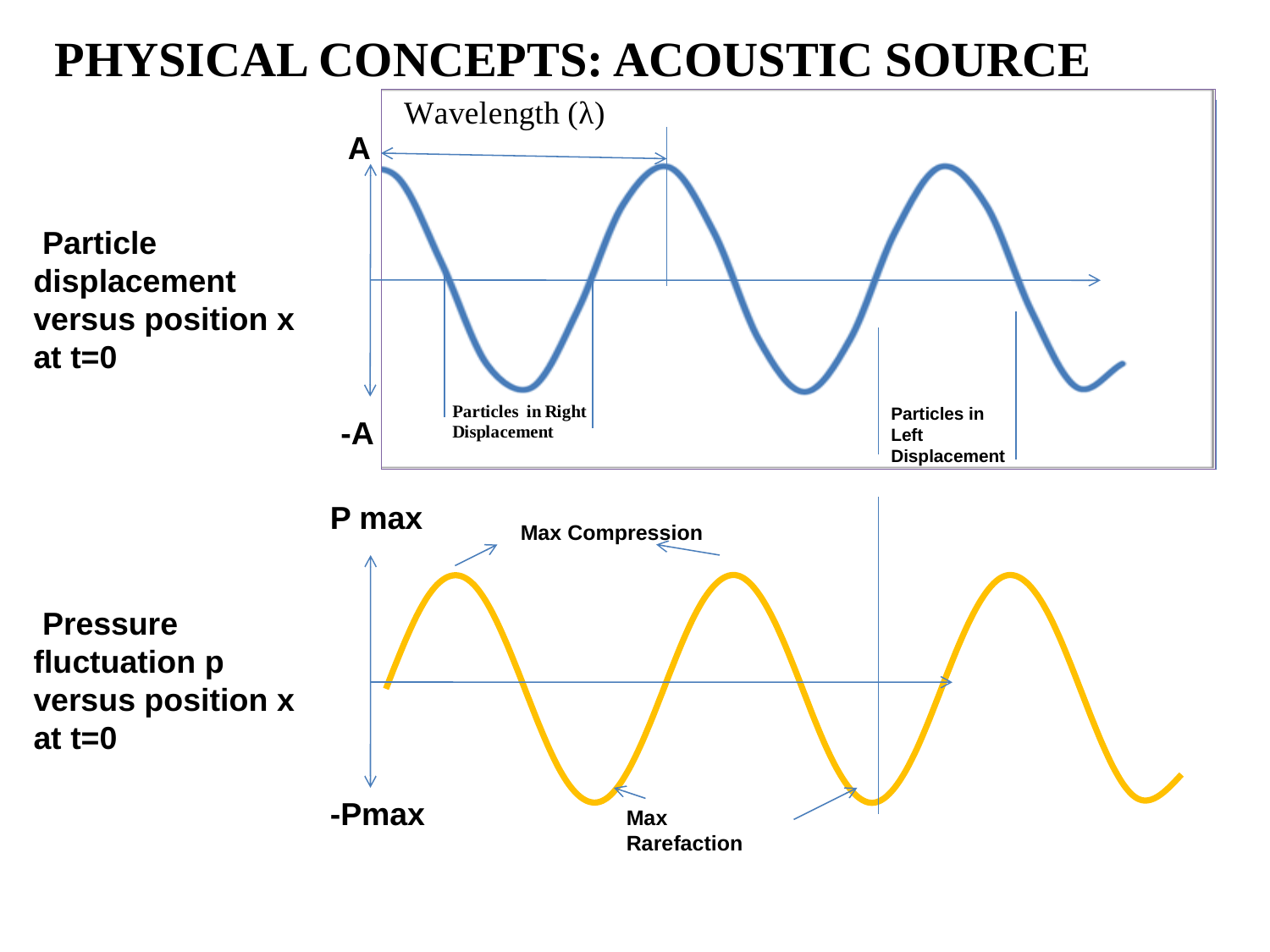
In the bottom chart, 'Pressure fluctuation p versus position x at t=0', does the wave rise or fall immediately after x=0? rise In the bottom chart, 'Pressure fluctuation p versus position x at t=0', how many troughs (minima) of the wave are shown? 3 In the bottom chart, 'Pressure fluctuation p versus position x at t=0', what colour is the plotted wave? yellow In the top chart, 'Particle displacement versus position x at t=0', does the wave rise or fall immediately after x=0? fall What kind of chart is the top chart, 'Particle displacement versus position x at t=0'? line chart What kind of chart is the bottom chart, 'Pressure fluctuation p versus position x at t=0'? line chart In the top chart, 'Particle displacement versus position x at t=0', what are the labels at the top and bottom of the vertical axis? A and -A In the top chart, 'Particle displacement versus position x at t=0', is the displacement at x=0 greater or less than 0? greater In the top chart, 'Particle displacement versus position x at t=0', how many peaks (maxima) of the wave are shown? 3